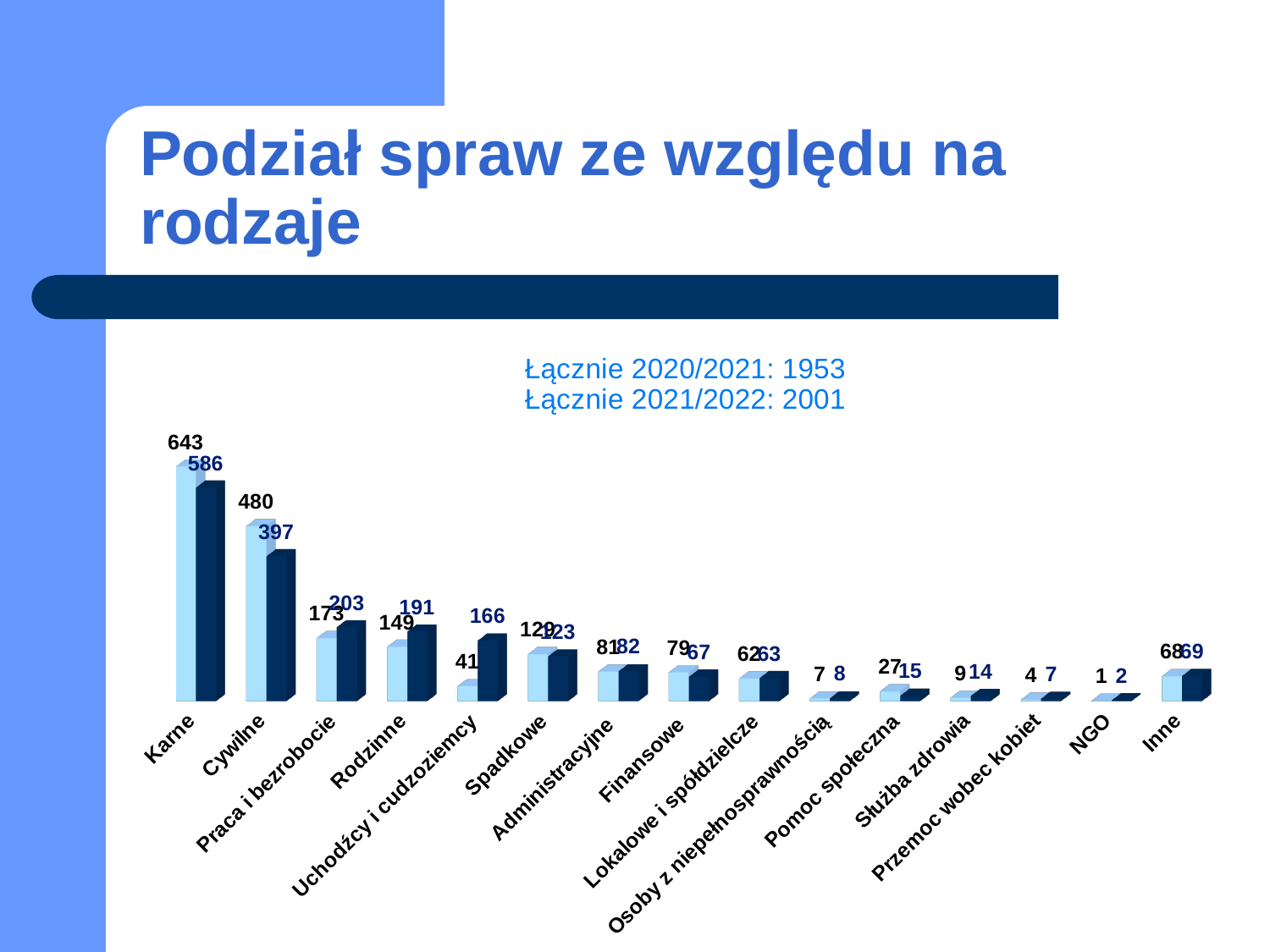
What is the difference between the light-blue and dark-blue bars for Uchodźcy i cudzoziemcy? 125 Which is larger for Rodzinne, the light-blue bar or the dark-blue bar? the dark-blue bar What is the value of the dark-blue bar for Uchodźcy i cudzoziemcy? 166 What is the difference between the light-blue and dark-blue bars for Karne? 57 What kind of chart is shown on the slide? bar chart How many categories are shown along the x axis of the chart? 15 What is the value of the light-blue bar for Karne? 643 Which category has the lowest dark-blue bar? NGO What is the value of the light-blue bar for Pomoc społeczna? 27 What is the value of the dark-blue bar for Cywilne? 397 What total is given on the slide for 2021/2022? 2001 Which category has the highest light-blue bar? Karne